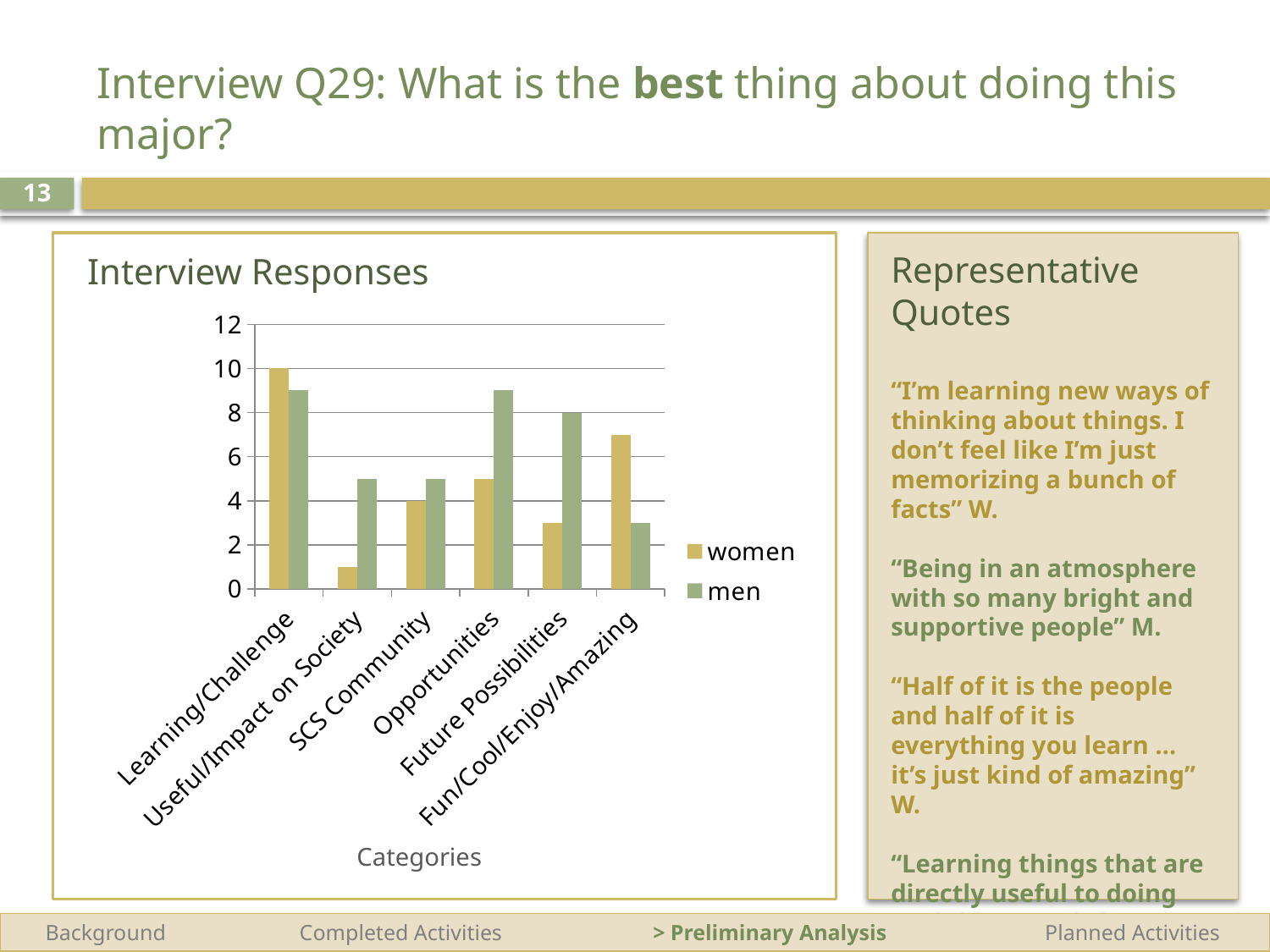
What is the difference between the women's values for Learning/Challenge and SCS Community? 6 What type of chart is shown under "Interview Responses"? bar chart Is the value for men in the Useful/Impact on Society category greater or less than 4? greater How many categories are shown on the x axis of the Interview Responses chart? 6 Which category has the lowest value for men? Fun/Cool/Enjoy/Amazing Which category has the highest value for women? Learning/Challenge What is the value for women in the SCS Community category? 4 What is the value for women in the Learning/Challenge category? 10 Which category has the lowest value for women? Useful/Impact on Society How many series does the legend of the Interview Responses chart list? 2 In the Opportunities category, which is larger, the value for women or the value for men? men What is the value for men in the Future Possibilities category? 8